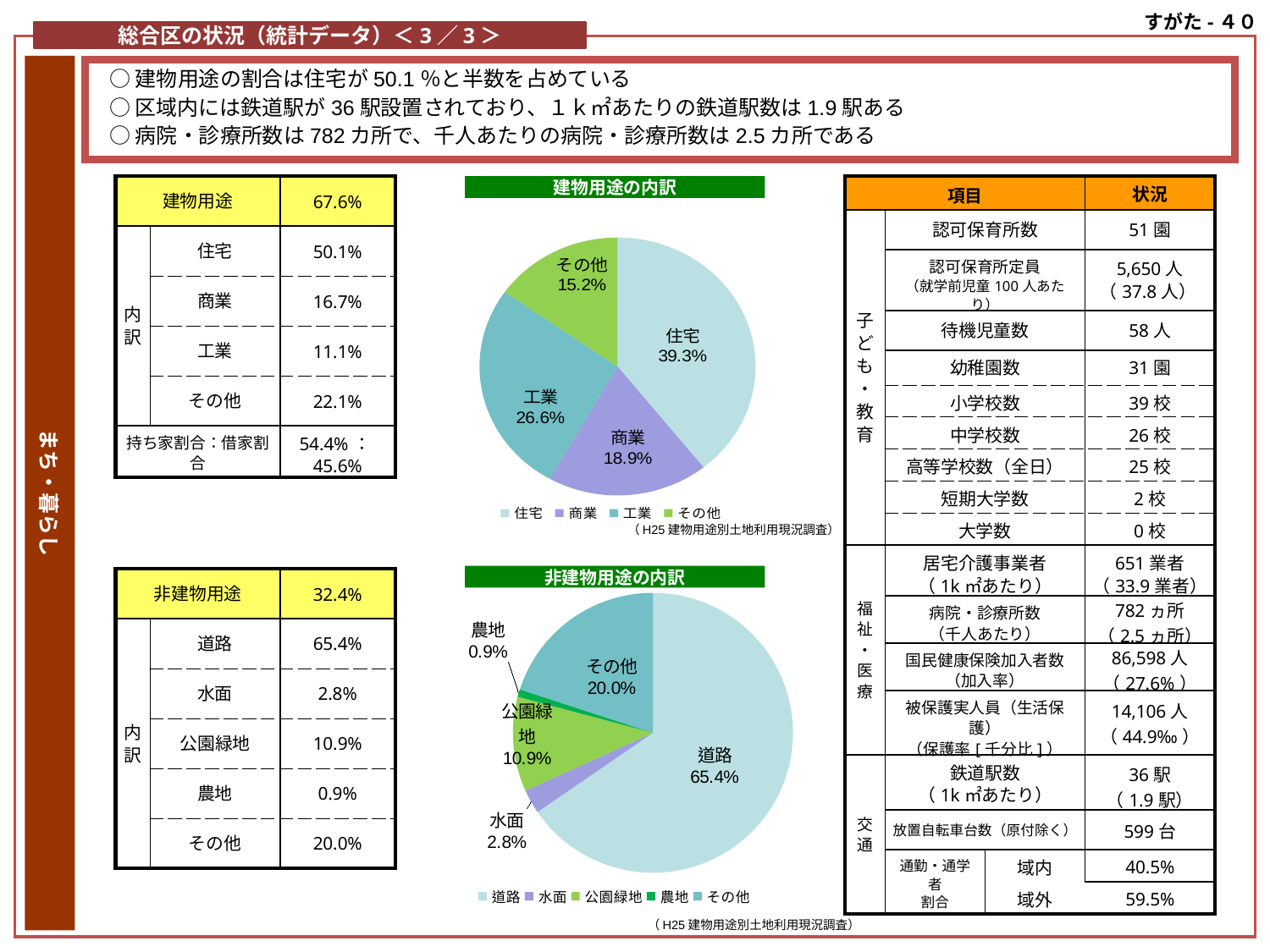
In the 非建物用途の内訳 chart, which category has the smallest share? 農地 What kind of chart is the 非建物用途の内訳 chart? pie chart In the 建物用途の内訳 chart, what percentage is shown for 住宅? 39.3% In the 非建物用途の内訳 chart, what percentage is shown for 道路? 65.4% In the 建物用途の内訳 chart, what percentage is shown for 工業? 26.6% In the 建物用途の内訳 chart, how many categories does the legend list? 4 In the 建物用途の内訳 chart, which category has the smallest share? その他 In the 非建物用途の内訳 chart, how many slices are there? 5 In the 非建物用途の内訳 chart, which is larger, その他 or 水面? その他 In the 非建物用途の内訳 chart, what percentage is shown for 公園緑地? 10.9% In the 建物用途の内訳 chart, what is the difference between the shares of 工業 and 商業? 7.7% In the 建物用途の内訳 chart, which category has the largest share? 住宅